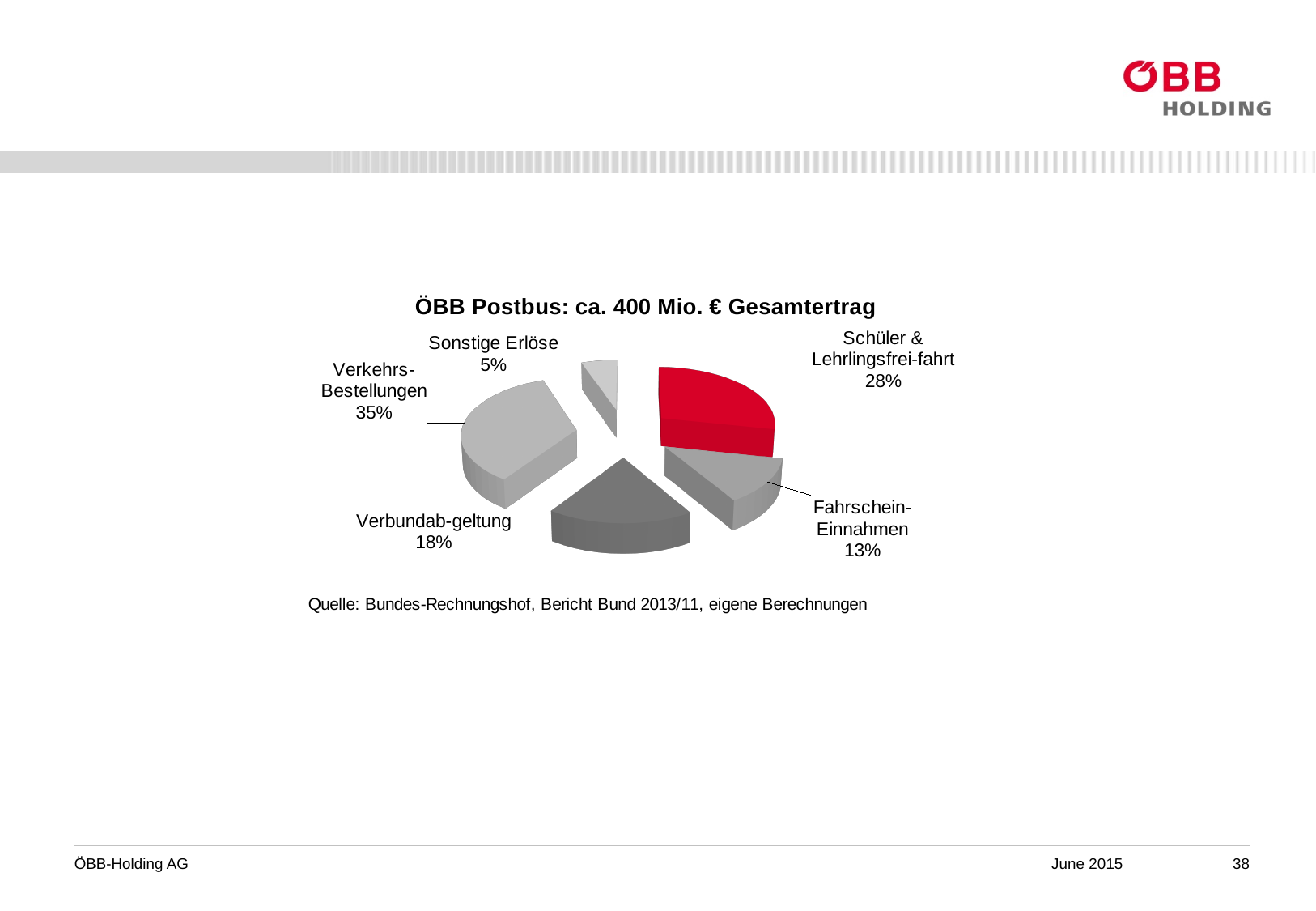
What is the title of the chart? ÖBB Postbus: ca. 400 Mio. € Gesamtertrag Which is larger, Schüler & Lehrlingsfrei-fahrt or Fahrschein-Einnahmen? Schüler & Lehrlingsfrei-fahrt What is the value shown for Fahrschein-Einnahmen? 13% What kind of chart is shown on the slide? Pie chart What is the value shown for Sonstige Erlöse? 5% What is the difference in percentage points between Verkehrs-Bestellungen and Verbundab-geltung? 17 What share of the pie is Schüler & Lehrlingsfrei-fahrt? 28% What share of the pie is Verkehrs-Bestellungen? 35% How many slices does the pie chart have? 5 Which category has the smallest share of the pie? Sonstige Erlöse Which category has the largest share of the pie? Verkehrs-Bestellungen Which slice of the pie is coloured red? Schüler & Lehrlingsfrei-fahrt